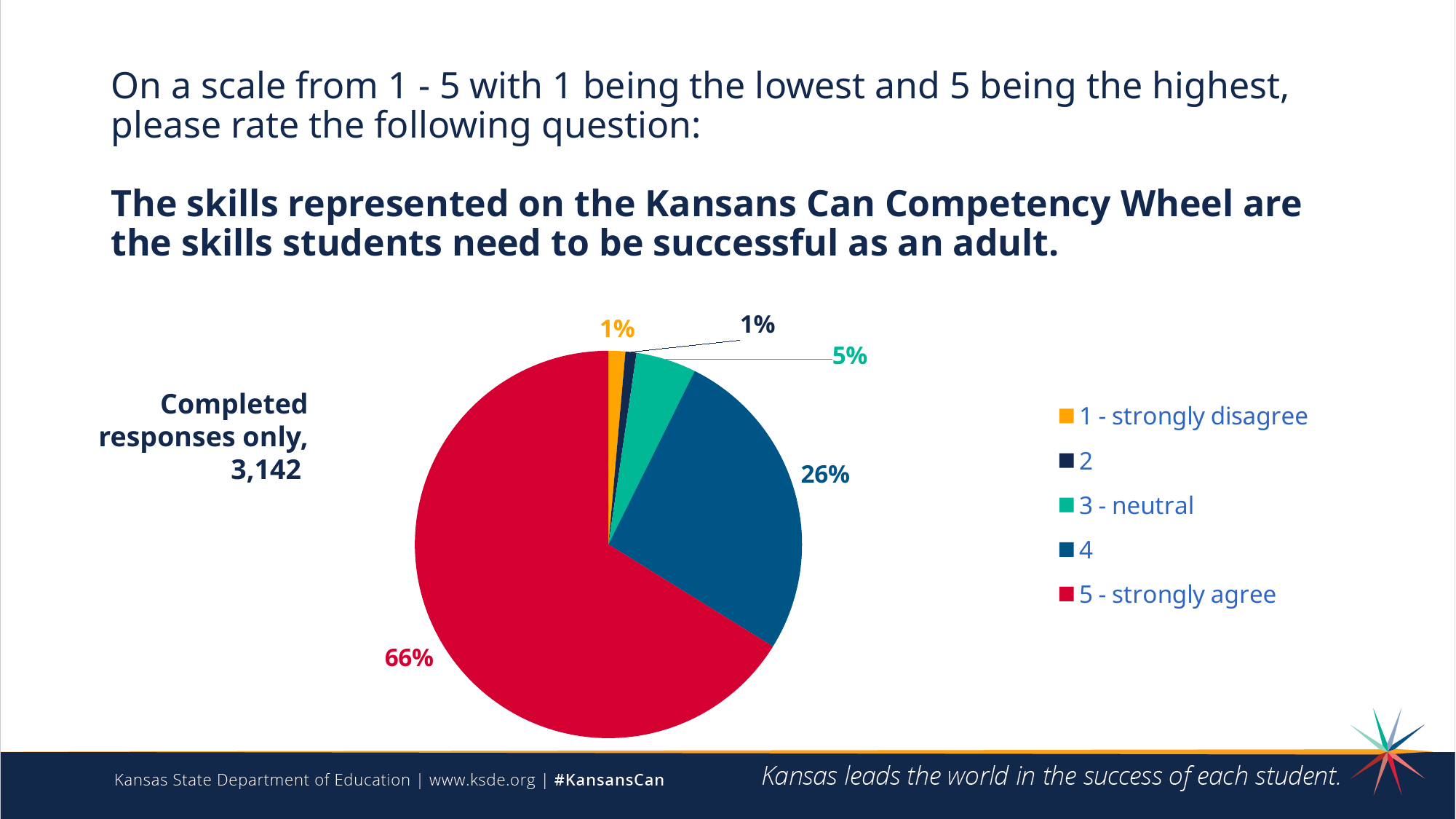
What percentage of responses were '1 - strongly disagree'? 1% How many completed responses does the slide say the chart is based on? 3,142 How many categories does the legend list? 5 What percentage of responses were '3 - neutral'? 5% What is the difference in percentage points between '5 - strongly agree' and '4'? 40 What kind of chart is shown on the slide? pie chart What is the combined percentage of responses rated '4' and '5 - strongly agree'? 92% What percentage of responses were '5 - strongly agree'? 66% Which is larger, the share for '4' or the share for '3 - neutral'? 4 Which rating category has the largest share of the pie? 5 - strongly agree What percentage of responses were rated '4'? 26% What colour represents '3 - neutral' in the pie chart? green